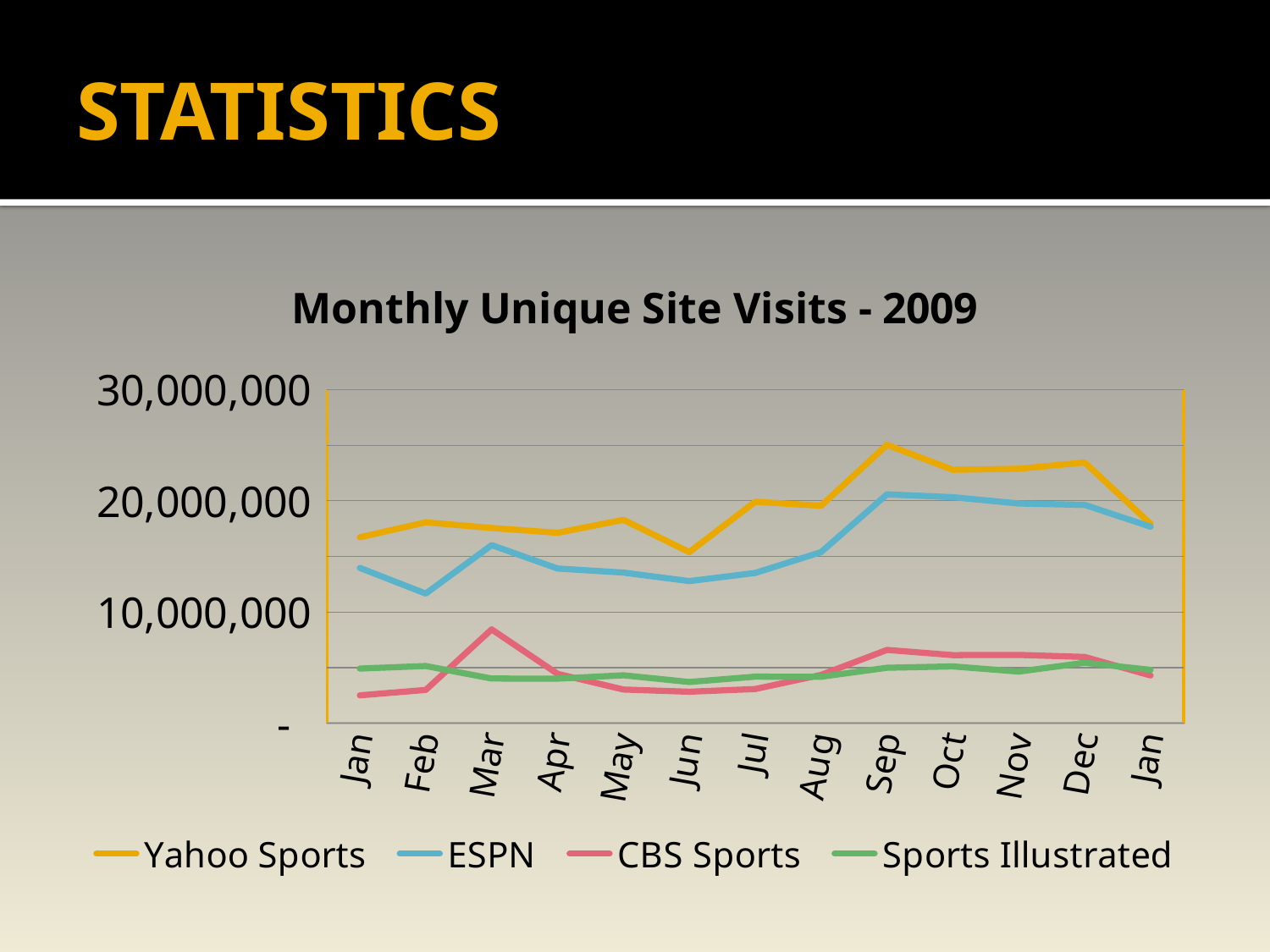
In which month does ESPN reach its lowest value? Feb Is the value for Yahoo Sports in Sep greater or less than 20,000,000? greater Which series is drawn in green? Sports Illustrated What is the title of the chart? Monthly Unique Site Visits - 2009 In which month does CBS Sports reach its highest value? Mar What kind of chart is shown on the slide? line chart Which is larger in Mar, CBS Sports or Sports Illustrated? CBS Sports In which month does Yahoo Sports reach its highest value? Sep Does the Yahoo Sports line rise or fall from Jun to Sep? rise Is the value for CBS Sports in Mar greater or less than 10,000,000? less How many series does the legend list? 4 How many months are plotted along the x axis? 13